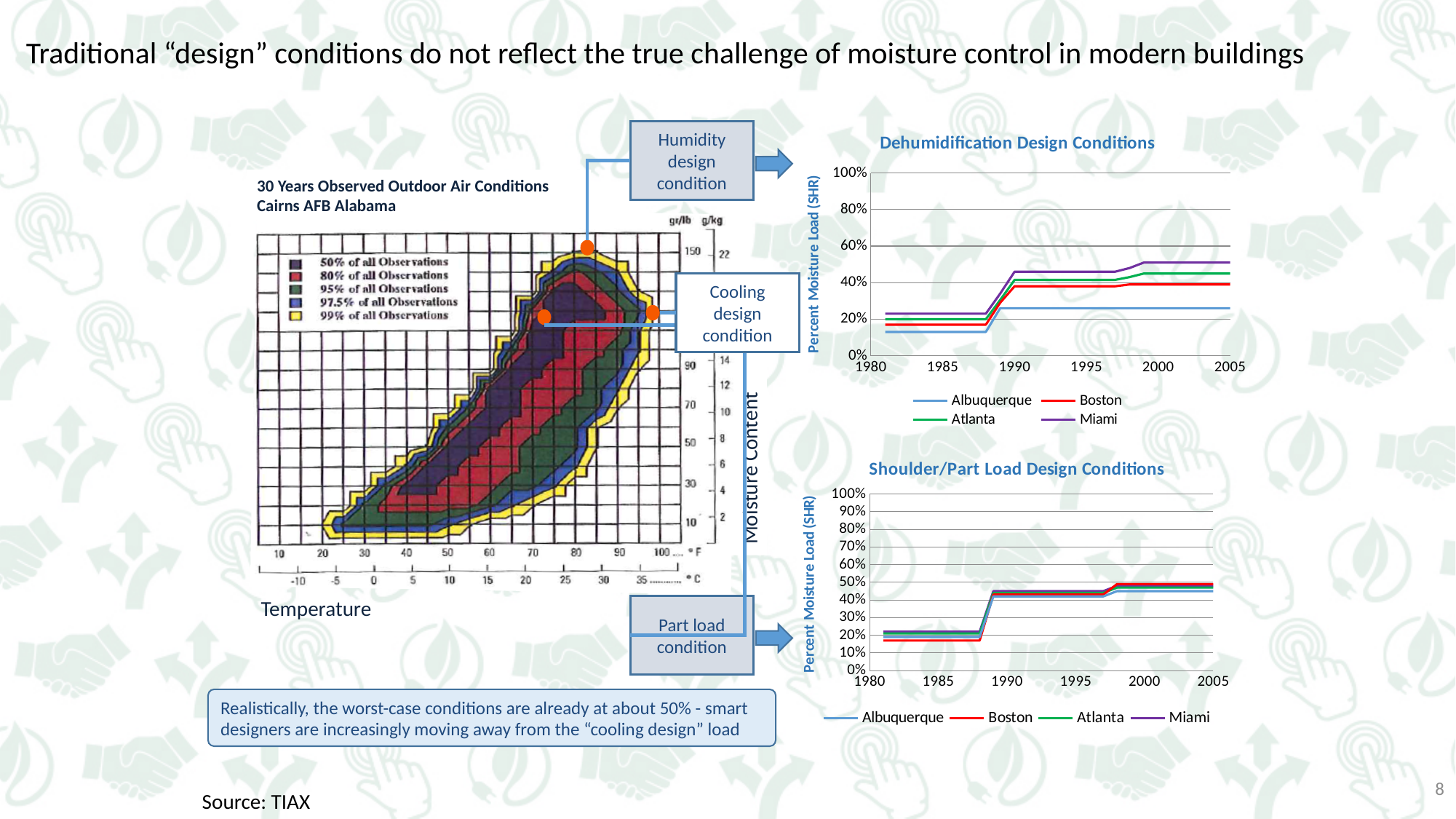
How many series does the legend of the 'Shoulder/Part Load Design Conditions' chart list? 4 What kind of chart is the 'Dehumidification Design Conditions' chart? line chart In the 'Dehumidification Design Conditions' chart, is the value for Albuquerque in 2005 greater or less than 40%? less What is the y-axis title of the 'Shoulder/Part Load Design Conditions' chart? Percent Moisture Load (SHR) In the 'Dehumidification Design Conditions' chart, do the values for Miami rise or fall from 1980 to 2005? rise In the 'Shoulder/Part Load Design Conditions' chart, is the value for Boston in 1985 greater or less than 20%? less What kind of chart is the 'Shoulder/Part Load Design Conditions' chart? line chart In the 'Dehumidification Design Conditions' chart, which is higher in 2005, Atlanta or Boston? Atlanta In the 'Dehumidification Design Conditions' chart, which city has the lowest percent moisture load in 2005? Albuquerque In the 'Dehumidification Design Conditions' chart, is the value for Miami in 2005 greater or less than 40%? greater How many series does the legend of the 'Dehumidification Design Conditions' chart list? 4 In the 'Dehumidification Design Conditions' chart, which city has the highest percent moisture load in 2005? Miami